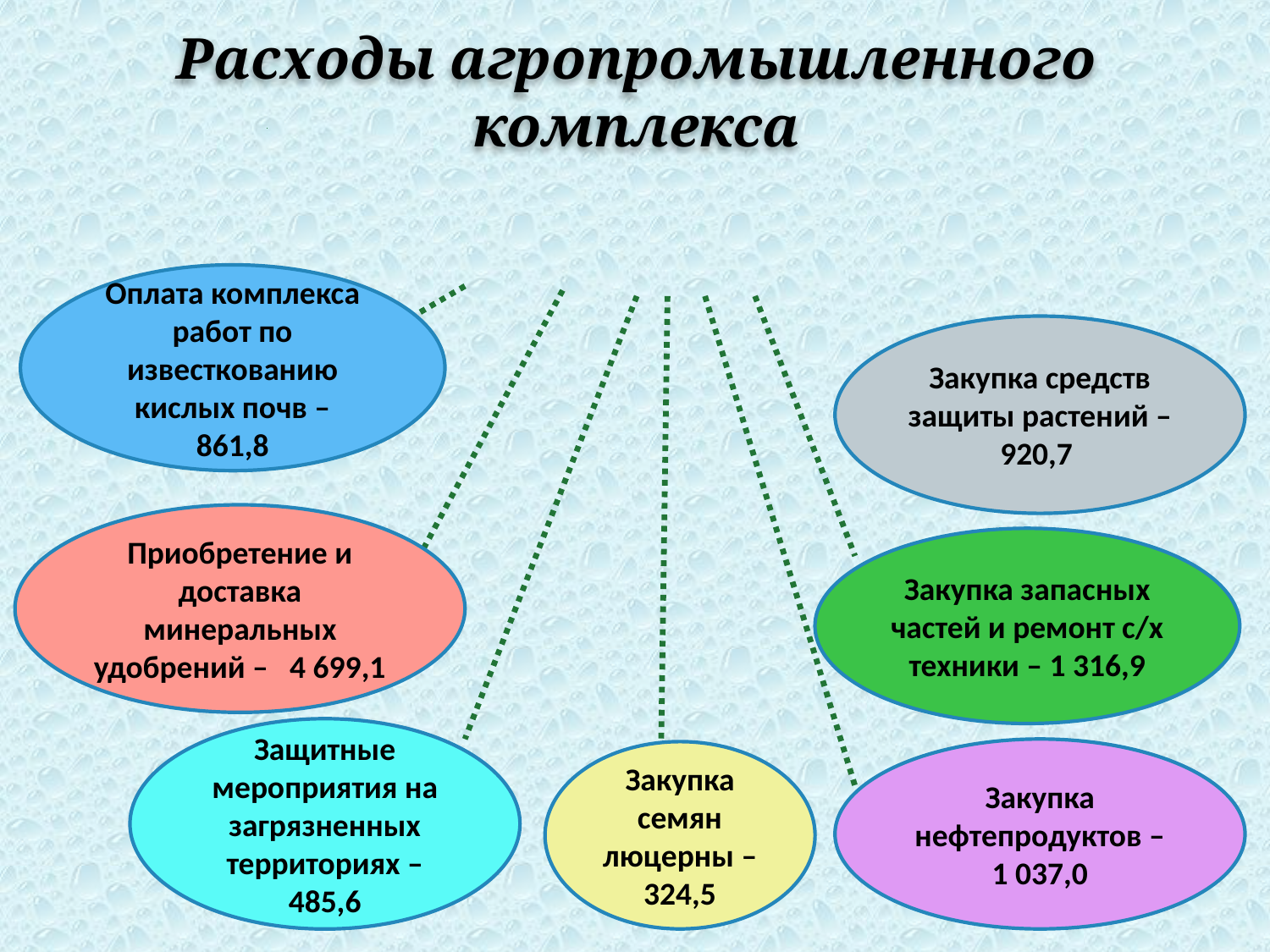
What is the difference between «Закупка запасных частей и ремонт с/х техники» and «Закупка нефтепродуктов»? 279,9 Which expense item has the highest value? Приобретение и доставка минеральных удобрений What is the value shown for «Оплата комплекса работ по известкованию кислых почв»? 861,8 What is the value shown for «Закупка семян люцерны»? 324,5 What is the value shown for «Закупка нефтепродуктов»? 1 037,0 Which expense item has the lowest value? Закупка семян люцерны How many expense items are shown on the slide? 7 What colour is the oval for «Закупка запасных частей и ремонт с/х техники»? Green What is the value shown for «Закупка средств защиты растений»? 920,7 What is the difference between «Закупка средств защиты растений» and «Оплата комплекса работ по известкованию кислых почв»? 58,9 Which is larger: «Защитные мероприятия на загрязненных территориях» or «Закупка семян люцерны»? Защитные мероприятия на загрязненных территориях What is the title of the slide? Расходы агропромышленного комплекса